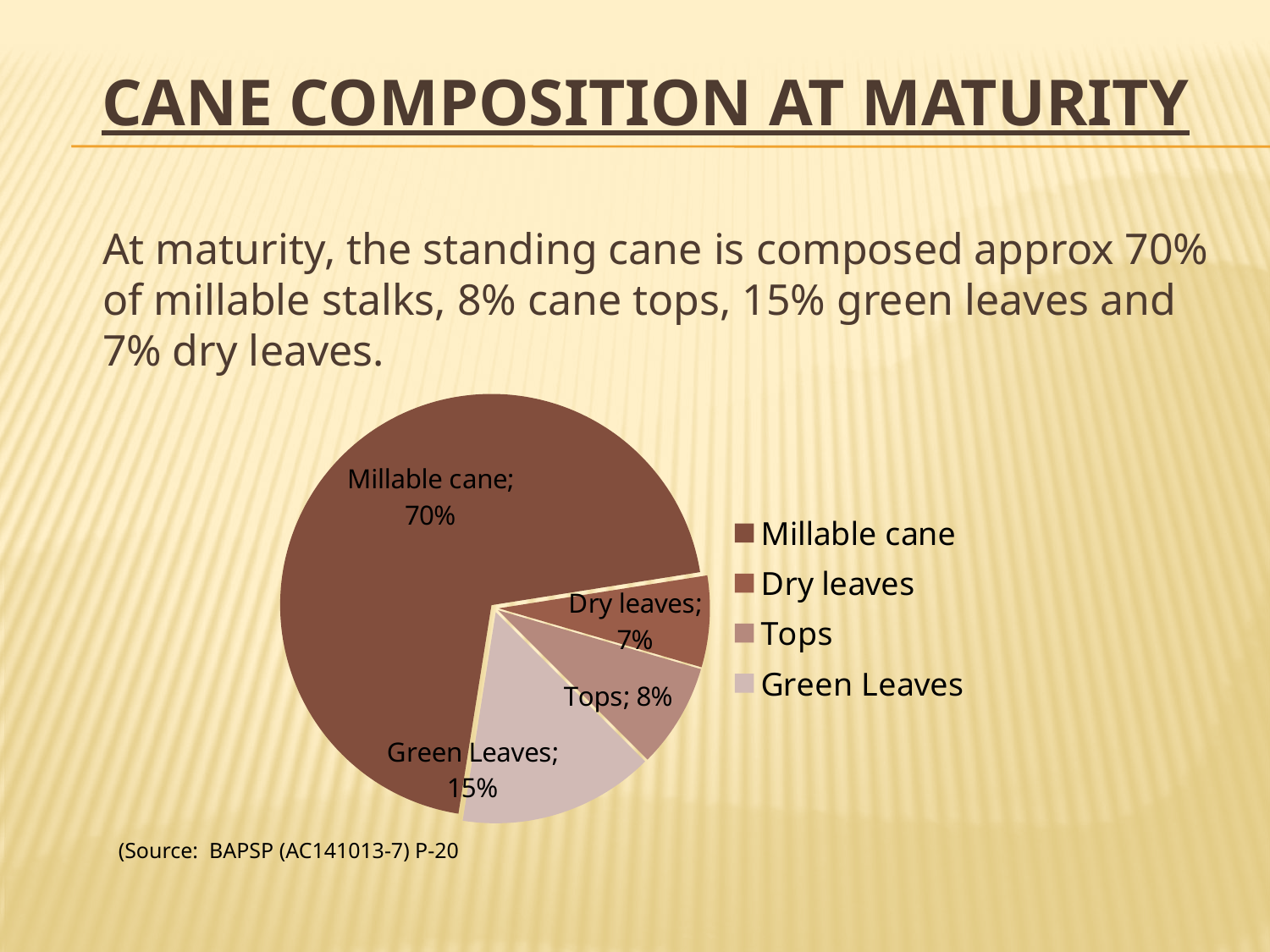
How many categories are shown in the pie chart? 4 Which category has the largest slice of the pie? Millable cane What is the title of the slide containing the chart? CANE COMPOSITION AT MATURITY Which category has the smallest slice of the pie? Dry leaves How many entries does the legend list? 4 What is the value shown for Tops? 8% What is the difference between the Millable cane share and the Green Leaves share? 55% What is the value shown for Dry leaves? 7% What share of the pie does Millable cane represent? 70% What kind of chart is shown on the slide? pie chart What is the value shown for Green Leaves? 15% Which is larger, the share for Green Leaves or the share for Tops? Green Leaves